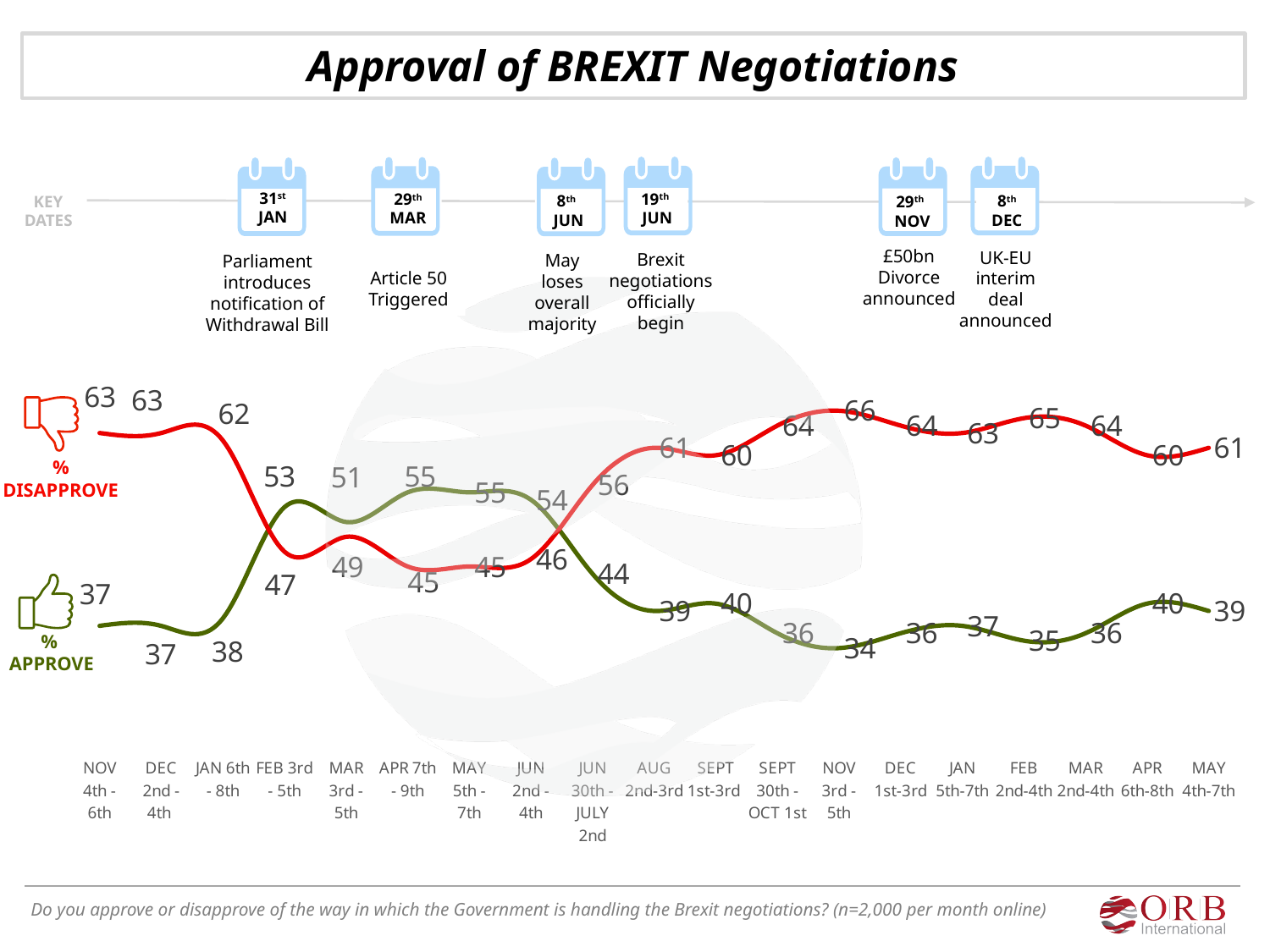
In which survey period does % DISAPPROVE reach its highest value? NOV 3rd-5th What is the difference between % DISAPPROVE and % APPROVE for NOV 3rd-5th? 32 Which is larger for APR 7th-9th, % APPROVE or % DISAPPROVE? % APPROVE What is the % APPROVE value for FEB 3rd-5th? 53 What is the % DISAPPROVE value for NOV 4th-6th? 63 What colour is the % DISAPPROVE line? red What is the % DISAPPROVE value for MAY 4th-7th? 61 Does % APPROVE rise or fall between JUN 2nd-4th and AUG 2nd-3rd? fall What type of chart is shown on the slide? line chart How many survey periods are plotted on the x axis? 19 How many series does the chart show? 2 In which survey period does % APPROVE reach its lowest value? NOV 3rd-5th